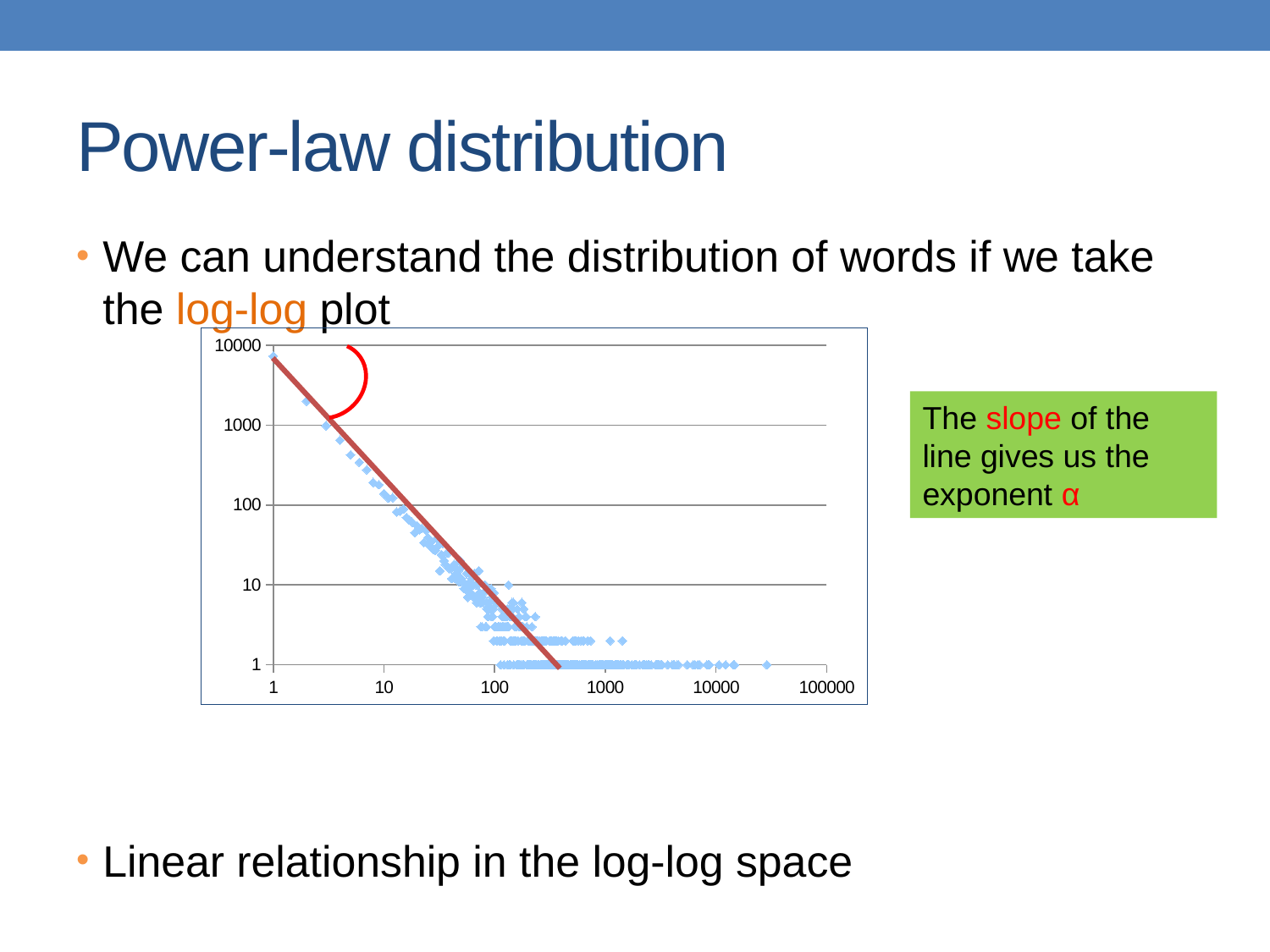
Are the lowest plotted points on the chart greater or less than 10 on the y axis? less Do the plotted values rise or fall as the x-axis value increases? fall How many tick labels are shown on the y axis of the chart? 5 Is the highest plotted point on the chart greater or less than 1000 on the y axis? greater How many tick labels are shown on the x axis of the chart? 6 Is the y value of the plotted point at x = 1 greater or less than 1000? greater What is the largest value labelled on the x axis of the chart? 100000 What kind of chart is shown on the slide? scatter chart What is the largest value labelled on the y axis of the chart? 10000